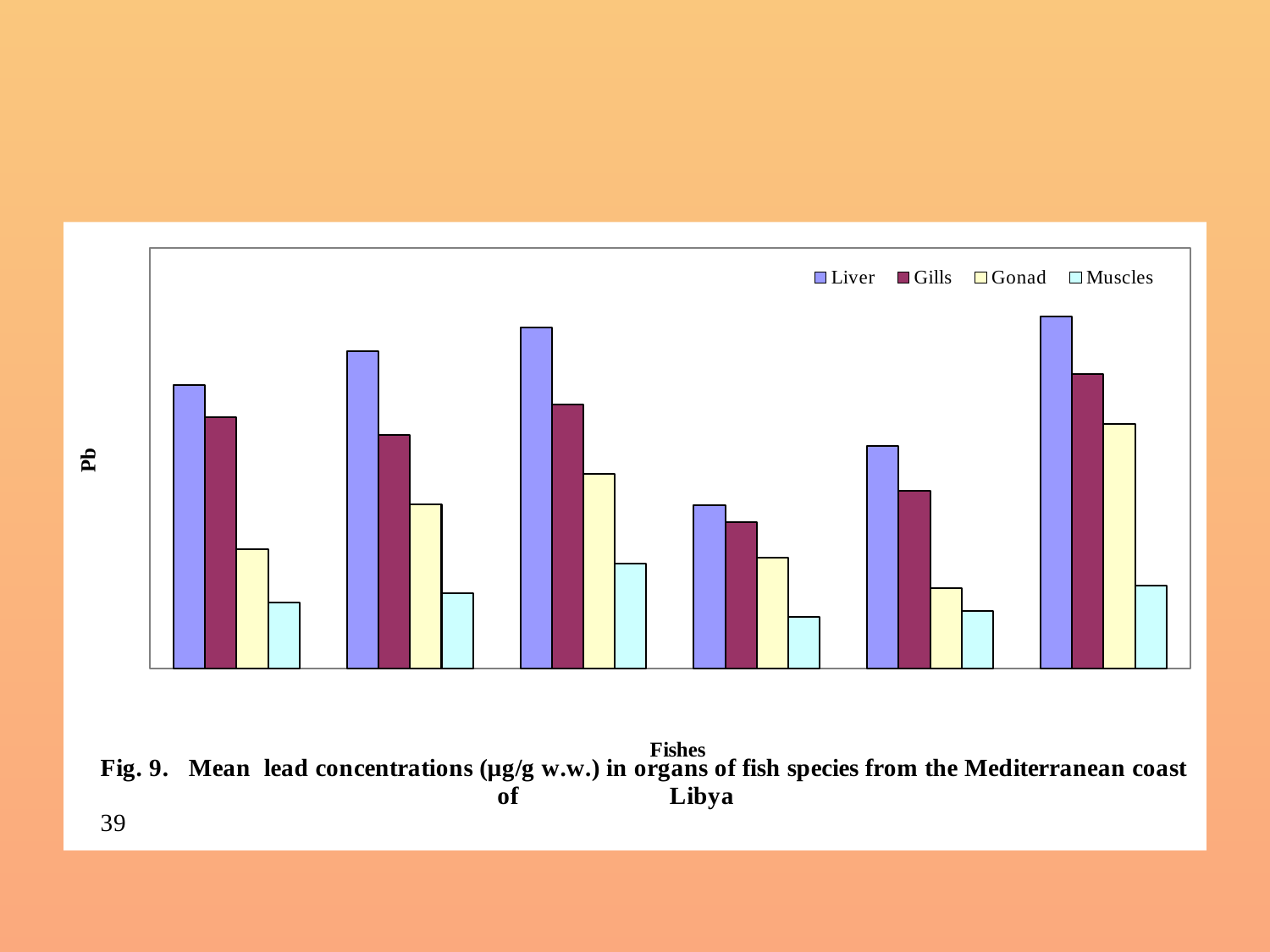
What are the four series named in the legend? Liver, Gills, Gonad, Muscles Which organ series has the tallest bar in every group of the chart? Liver How many groups of bars (fish species) are plotted on the chart? 6 In the rightmost group of bars, which is larger, the Liver value or the Gills value? Liver Which group of bars, counting from the left, has the tallest Liver bar? the sixth (rightmost) group In the leftmost group of bars, which is larger, the Gills value or the Gonad value? Gills Which organ series has the shortest bar in every group of the chart? Muscles What is the label on the vertical axis of the chart? Pb How many series does the legend list? 4 Which group of bars, counting from the left, has the shortest Liver bar? the fourth group What kind of chart is shown on the slide? bar chart